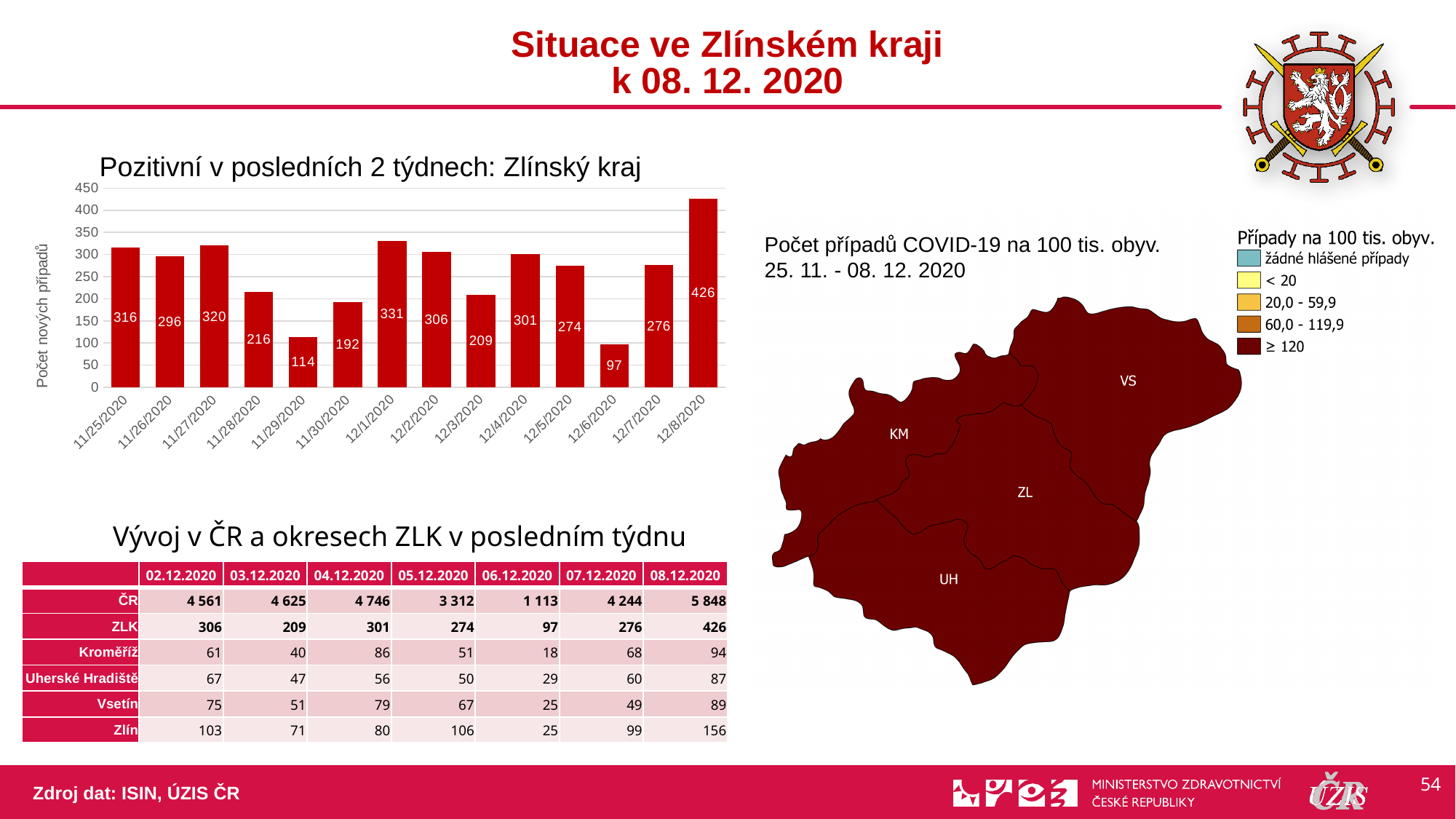
What is the value for 12/1/2020 in the bar chart? 331 Which is larger in the bar chart, the value for 11/25/2020 or the value for 11/26/2020? 11/25/2020 What type of chart is used to show the positive cases in the last 2 weeks? bar chart Which date has the lowest value in the bar chart? 12/6/2020 What is the difference between the values for 11/27/2020 and 11/28/2020 in the bar chart? 104 What is the value for 12/5/2020 in the bar chart? 274 What is the value for 11/29/2020 in the bar chart? 114 How many dates are shown on the x axis of the bar chart? 14 Is the value for 12/8/2020 in the bar chart greater or less than 400? greater What is the difference between the values for 12/8/2020 and 12/7/2020 in the bar chart? 150 Which date has the highest value in the bar chart? 12/8/2020 What is the title of the bar chart? Pozitivní v posledních 2 týdnech: Zlínský kraj